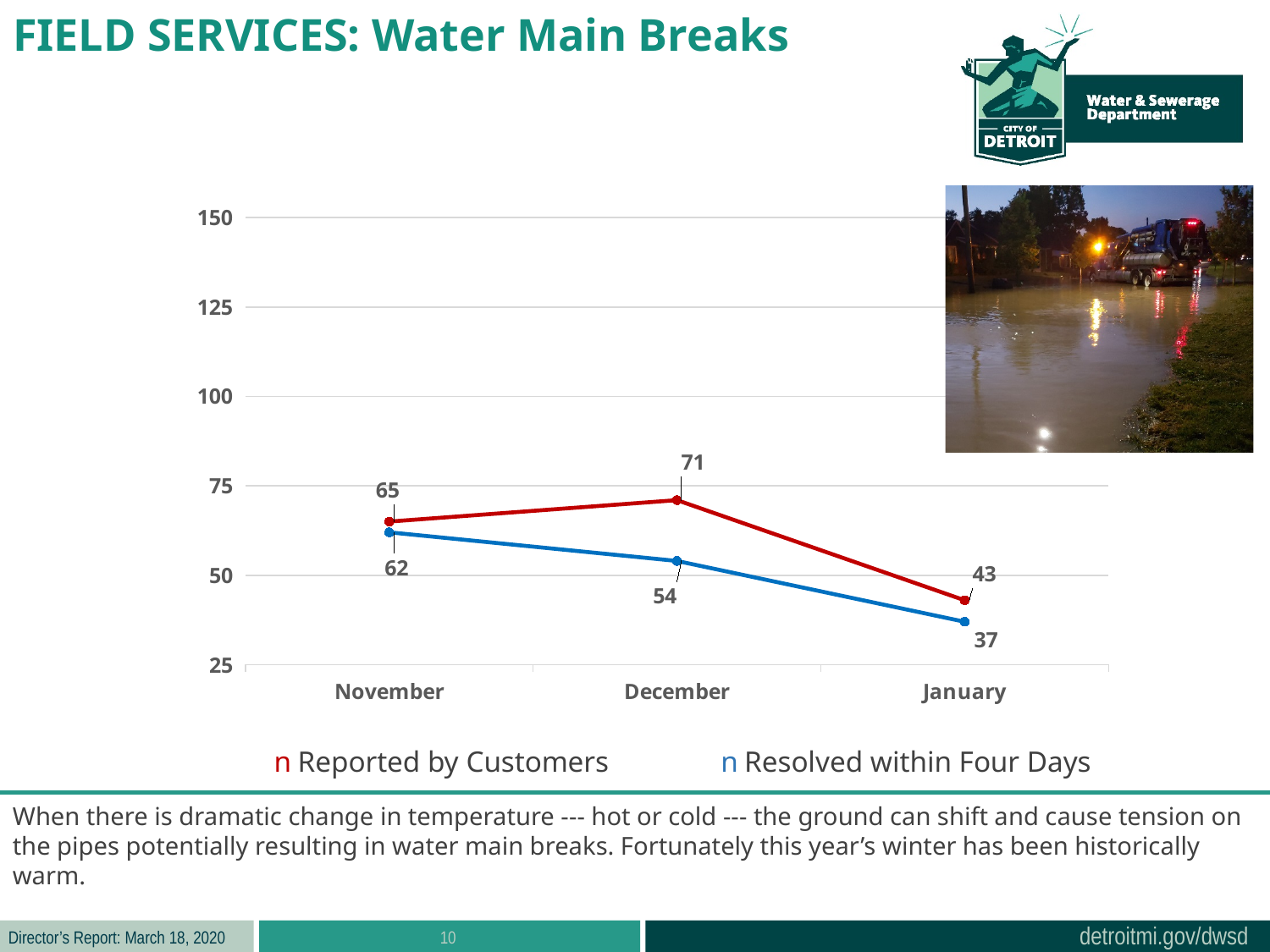
How many water main breaks were reported by customers in December? 71 What kind of chart is shown on the slide? Line chart Which colour is used for the Reported by Customers series? Red How many water main breaks were resolved within four days in January? 37 In which month was the number of breaks resolved within four days lowest? January Which is larger in January: breaks reported by customers or breaks resolved within four days? Reported by Customers What is the difference between breaks reported by customers and breaks resolved within four days in December? 17 How many series does the chart legend list? 2 How many water main breaks were reported by customers in November? 65 Do the breaks resolved within four days rise or fall from November to January? Fall In which month was the number of water main breaks reported by customers highest? December How many months are shown on the x axis of the chart? 3